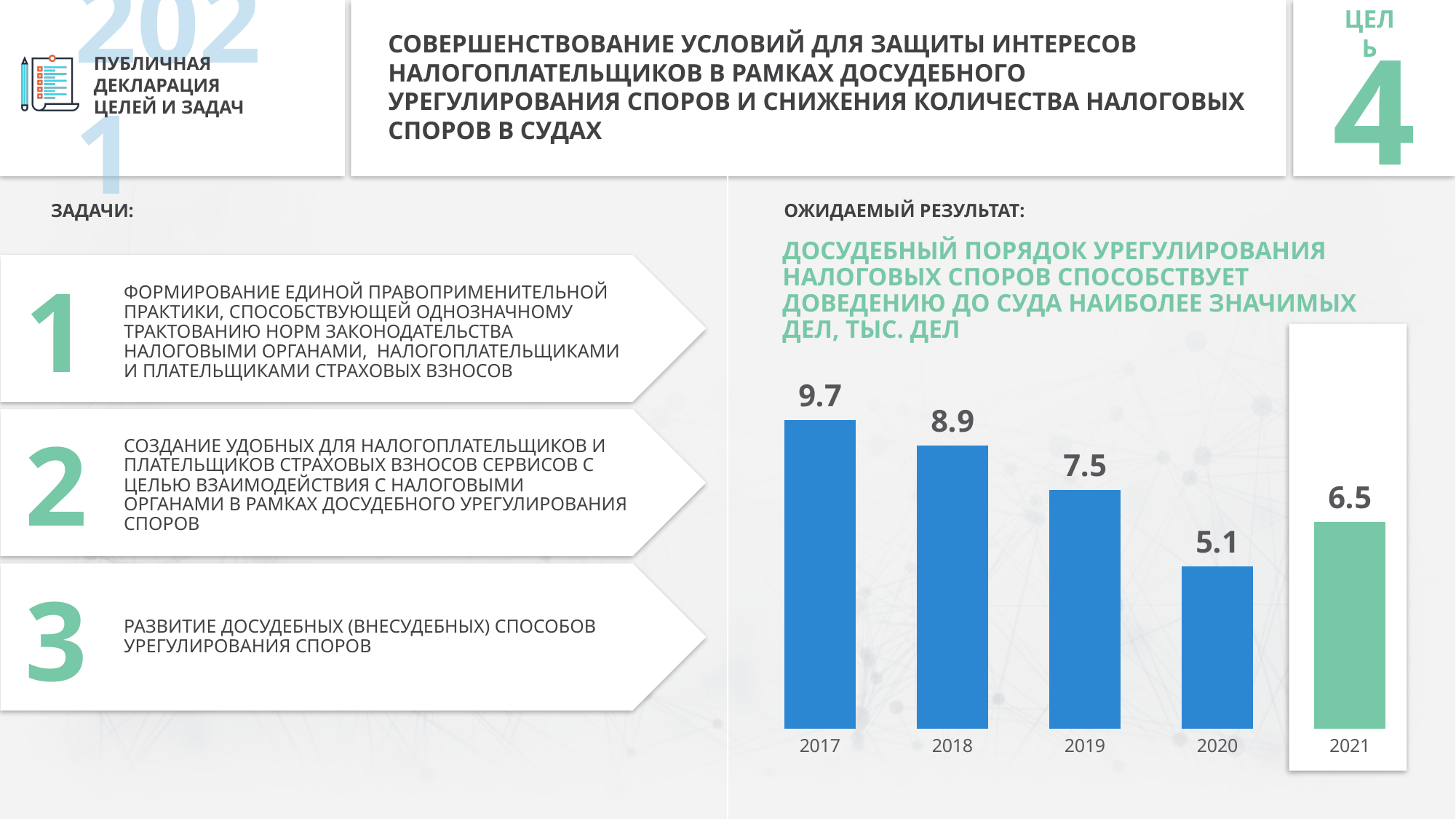
Do the values rise or fall from 2017 to 2020? fall What is the value for 2021? 6.5 What kind of chart is shown on the slide? bar chart What is the value for 2017? 9.7 What is the value for 2019? 7.5 What is the difference between the values for 2017 and 2020? 4.6 Which year's bar is coloured green rather than blue? 2021 How many years are shown on the chart? 5 What is the difference between the values for 2018 and 2019? 1.4 Which is larger, the value for 2020 or the value for 2021? 2021 Which year has the lowest value? 2020 Which year has the highest value? 2017